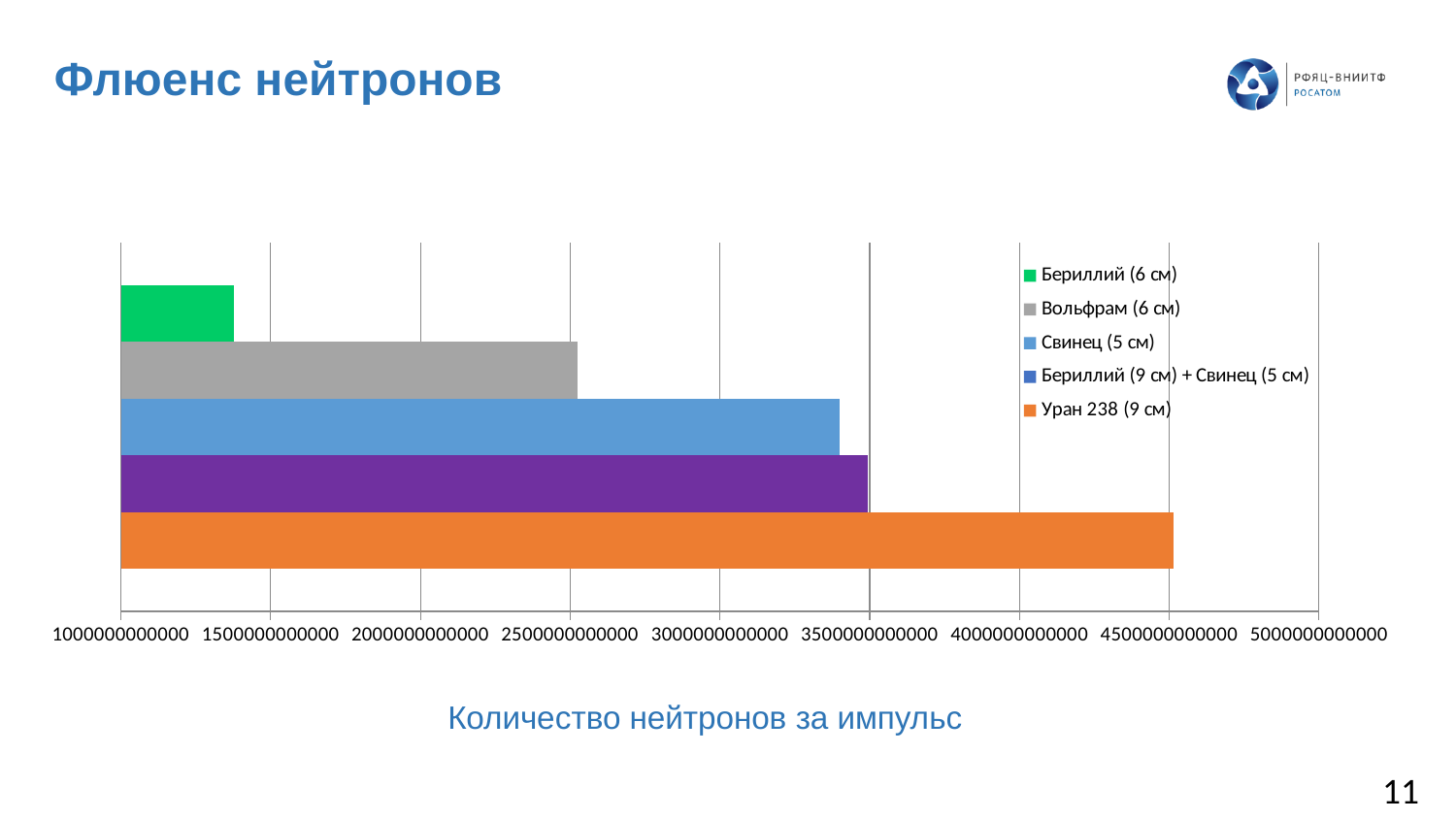
Which is larger, the value for Бериллий (6 см) or the value for Уран 238 (9 см)? Уран 238 (9 см) How many bars are plotted in the chart? 5 Which is larger, the value for Вольфрам (6 см) or the value for Свинец (5 см)? Свинец (5 см) Which series has the lowest value? Бериллий (6 см) Is the value for Свинец (5 см) greater or less than 3000000000000? greater How many series does the legend list? 5 What is the title of the slide containing the chart? Флюенс нейтронов What kind of chart is shown on the slide? bar chart Is the value for Уран 238 (9 см) greater or less than 4000000000000? greater Is the value for Бериллий (6 см) greater or less than 1500000000000? less Which series has the highest value? Уран 238 (9 см)